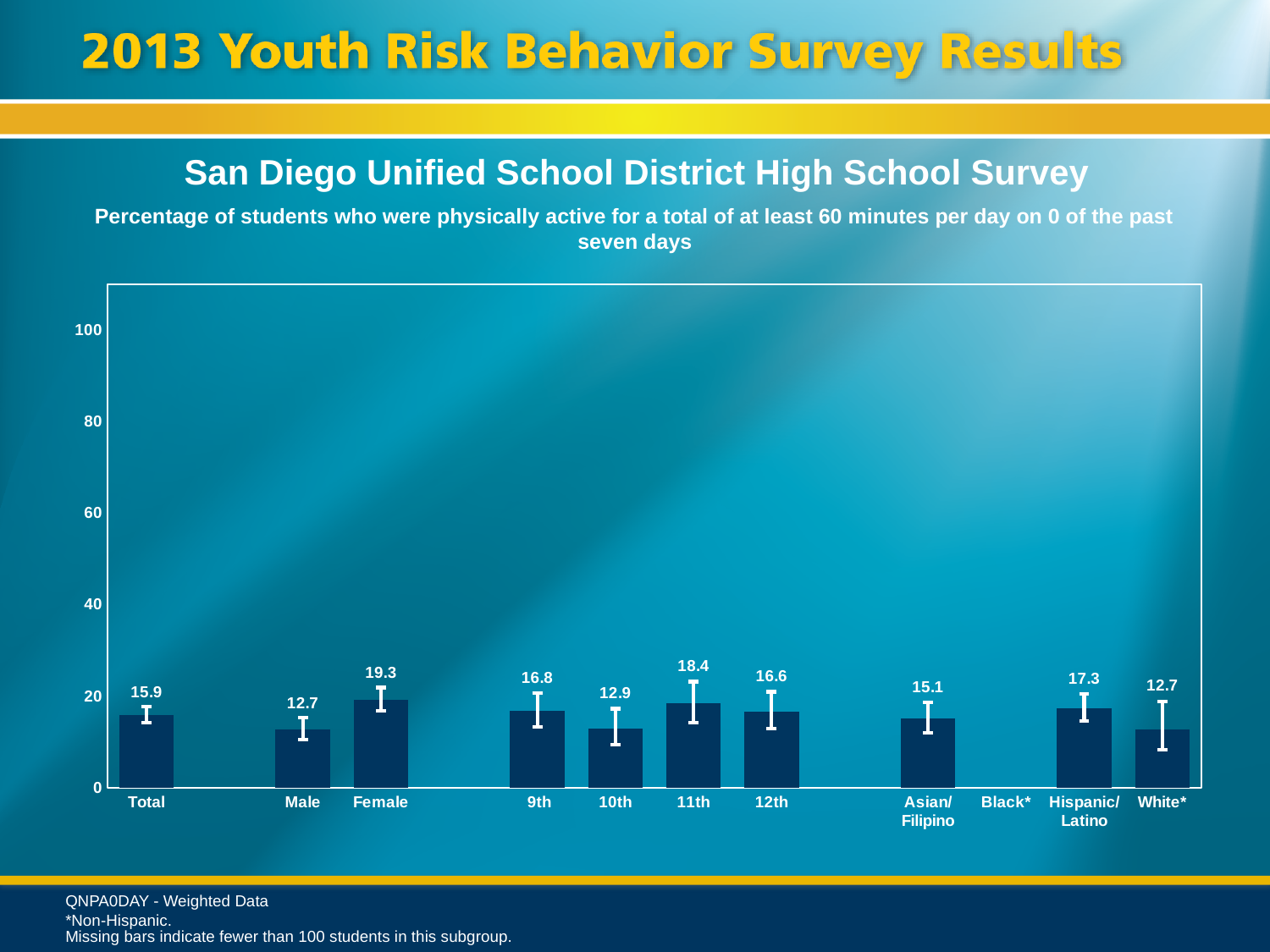
What is the value shown for 11th grade students? 18.4 Is the value for Asian/Filipino students greater or less than 20? less Which is larger, the value for 9th grade or the value for 12th grade? 9th Among the grade levels (9th, 10th, 11th, 12th), which has the lowest value? 10th What type of chart is shown on the slide? bar chart What is the value shown for Hispanic/Latino students? 17.3 Which category on the x axis has no bar displayed? Black* How many category labels are shown along the x axis? 11 What is the difference between the Female and Male values? 6.6 Which category has the highest value in the chart? Female What is the value shown for Female students? 19.3 What percentage of students in the Total category were physically active for at least 60 minutes per day on 0 of the past seven days? 15.9